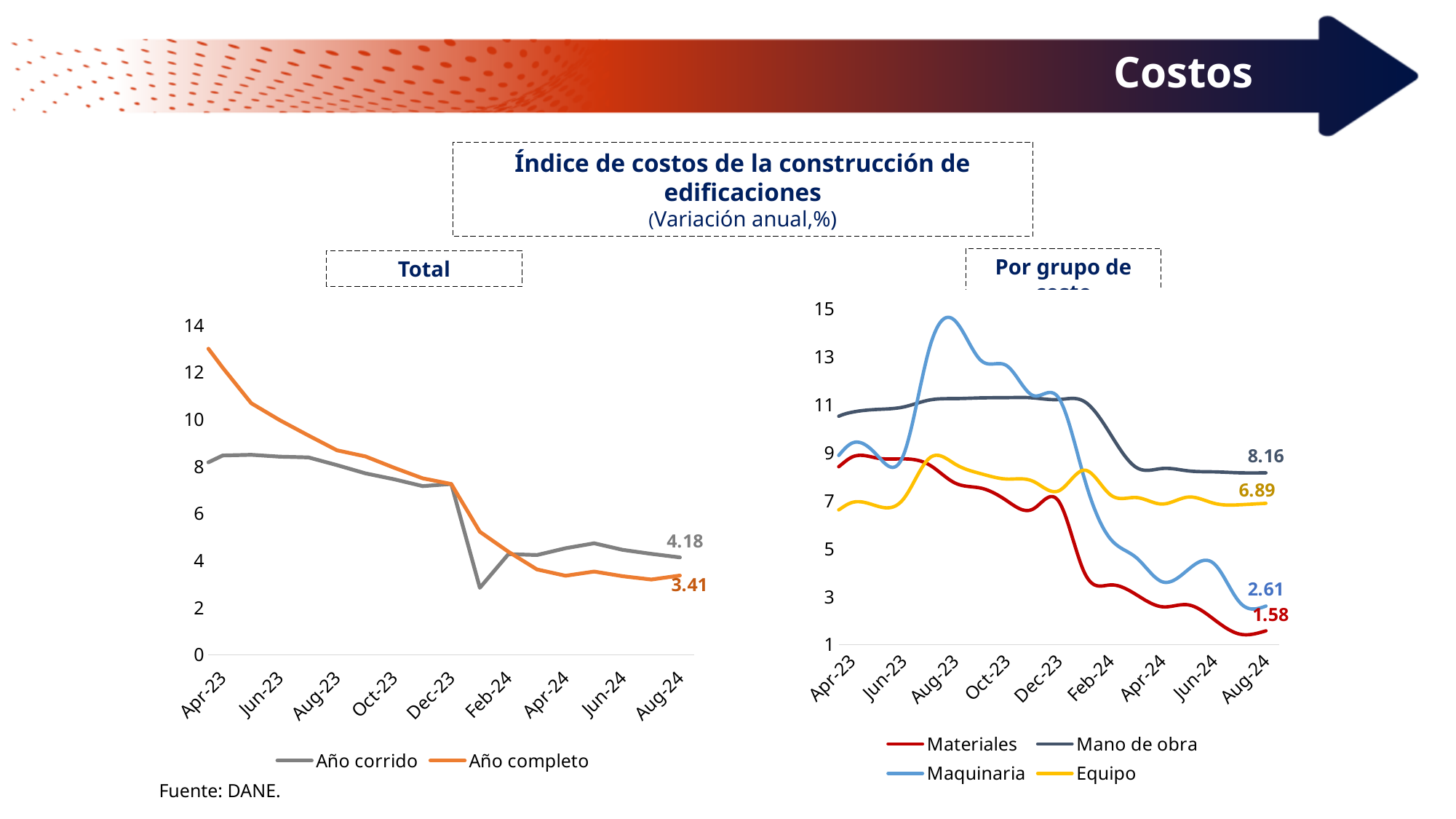
In the 'Por grupo de costo' chart, what is the final value shown for Materiales? 1.58 In the 'Por grupo de costo' chart, what is the difference between the final values of Mano de obra and Equipo? 1.27 In the 'Por grupo de costo' chart, which series has the highest final value? Mano de obra In the 'Total' chart, does the Año completo line rise or fall from Apr-23 to Aug-24? fall In the 'Por grupo de costo' chart, which series has the lowest final value? Materiales In the 'Por grupo de costo' chart, what is the final value shown for Mano de obra? 8.16 In the 'Total' chart, what is the final value shown for Año corrido? 4.18 How many series does the legend of the 'Por grupo de costo' chart list? 4 In the 'Total' chart, what is the difference between the final values of Año corrido and Año completo? 0.77 In the 'Total' chart, what is the final value shown for Año completo? 3.41 In the 'Por grupo de costo' chart, is the peak value of Maquinaria around Aug-23 greater or less than 13? greater In the 'Total' chart, is the value for Año completo at Apr-23 greater or less than 12? greater